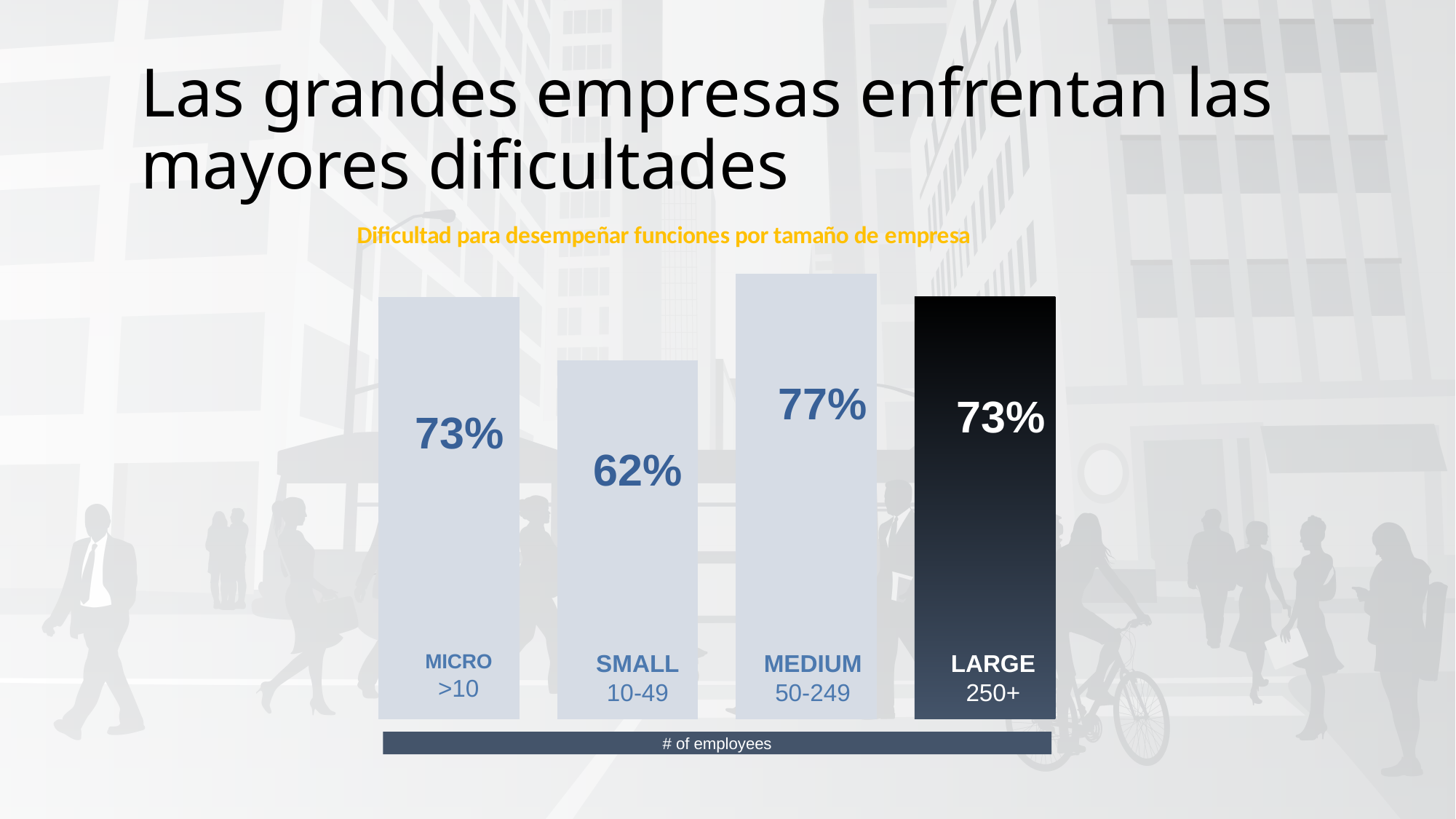
What is the difference between the values for MEDIUM and SMALL companies? 15 percentage points What kind of chart is shown on the slide? Bar chart What is the value for MEDIUM companies (50-249 employees)? 77% How many company size categories are shown in the chart? 4 What is the title of the chart? Dificultad para desempeñar funciones por tamaño de empresa Which company size has the lowest value? SMALL Which company size has the highest value? MEDIUM What is the value for LARGE companies (250+ employees)? 73% What is the value for MICRO companies? 73% What is the difference between the values for MICRO and SMALL companies? 11 percentage points Which is larger, the value for MEDIUM or the value for LARGE companies? MEDIUM What is the value for SMALL companies (10-49 employees)? 62%